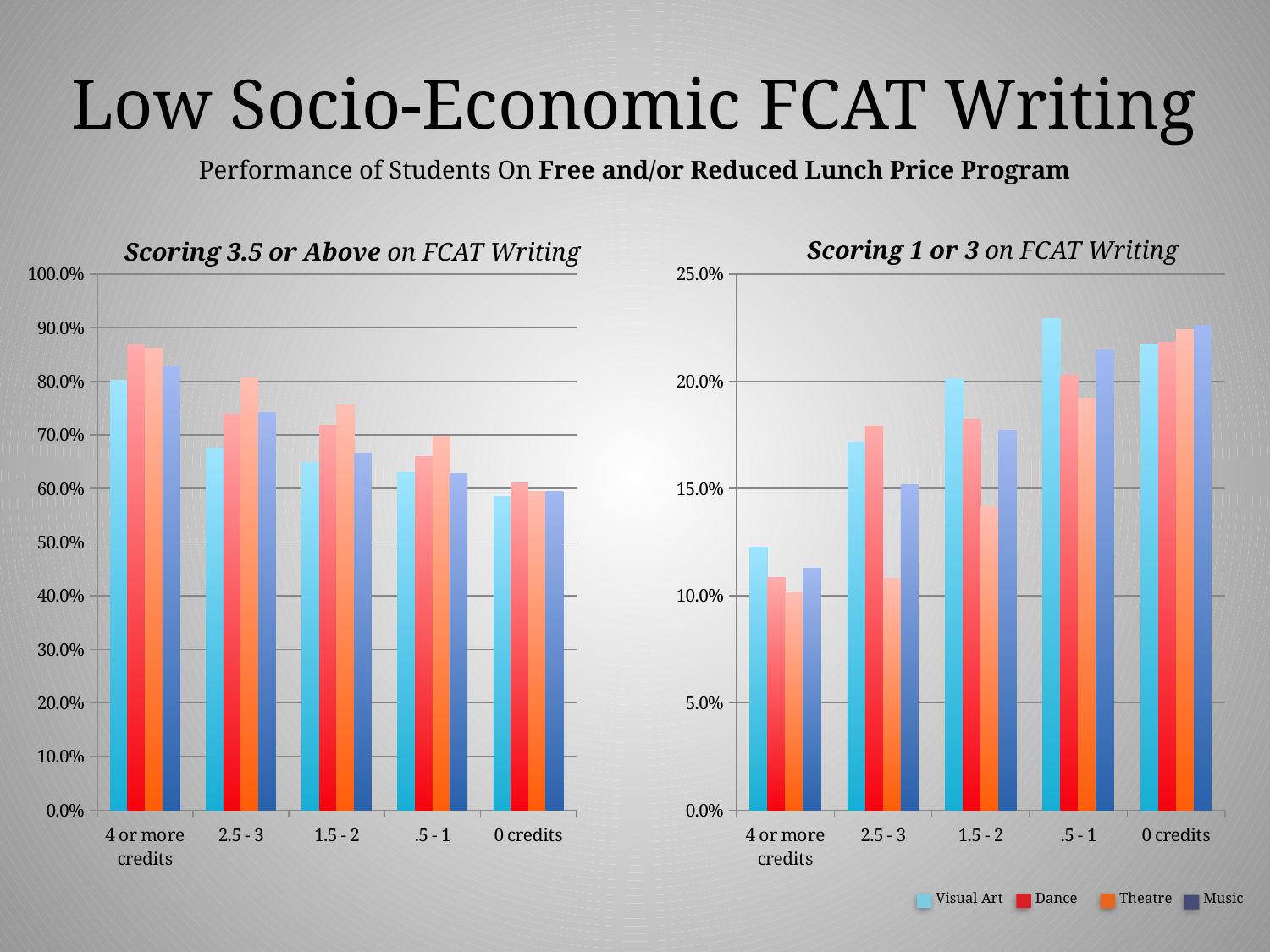
In the 'Scoring 1 or 3 on FCAT Writing' chart, do the Theatre values rise or fall from '4 or more credits' to '0 credits'? rise In the 'Scoring 3.5 or Above on FCAT Writing' chart, which credit category has the highest Theatre bar? 4 or more credits How many credit categories are shown on the x axis of the 'Scoring 3.5 or Above on FCAT Writing' chart? 5 In the 'Scoring 3.5 or Above on FCAT Writing' chart, is the Dance value for '4 or more credits' greater or less than 80.0%? greater Which series is shown in dark blue in the legend? Music In the 'Scoring 1 or 3 on FCAT Writing' chart, which credit category has the lowest Visual Art bar? 4 or more credits In the 'Scoring 3.5 or Above on FCAT Writing' chart, is the Visual Art value for '0 credits' greater or less than 50.0%? greater In the 'Scoring 1 or 3 on FCAT Writing' chart, which is larger for '1.5 - 2': Visual Art or Theatre? Visual Art In the 'Scoring 1 or 3 on FCAT Writing' chart, is the Visual Art value for '.5 - 1' greater or less than 20.0%? greater How many series does the legend list? 4 In the 'Scoring 3.5 or Above on FCAT Writing' chart, do the Visual Art values rise or fall from '4 or more credits' to '0 credits'? fall What kind of chart is the 'Scoring 3.5 or Above on FCAT Writing' chart? Bar chart